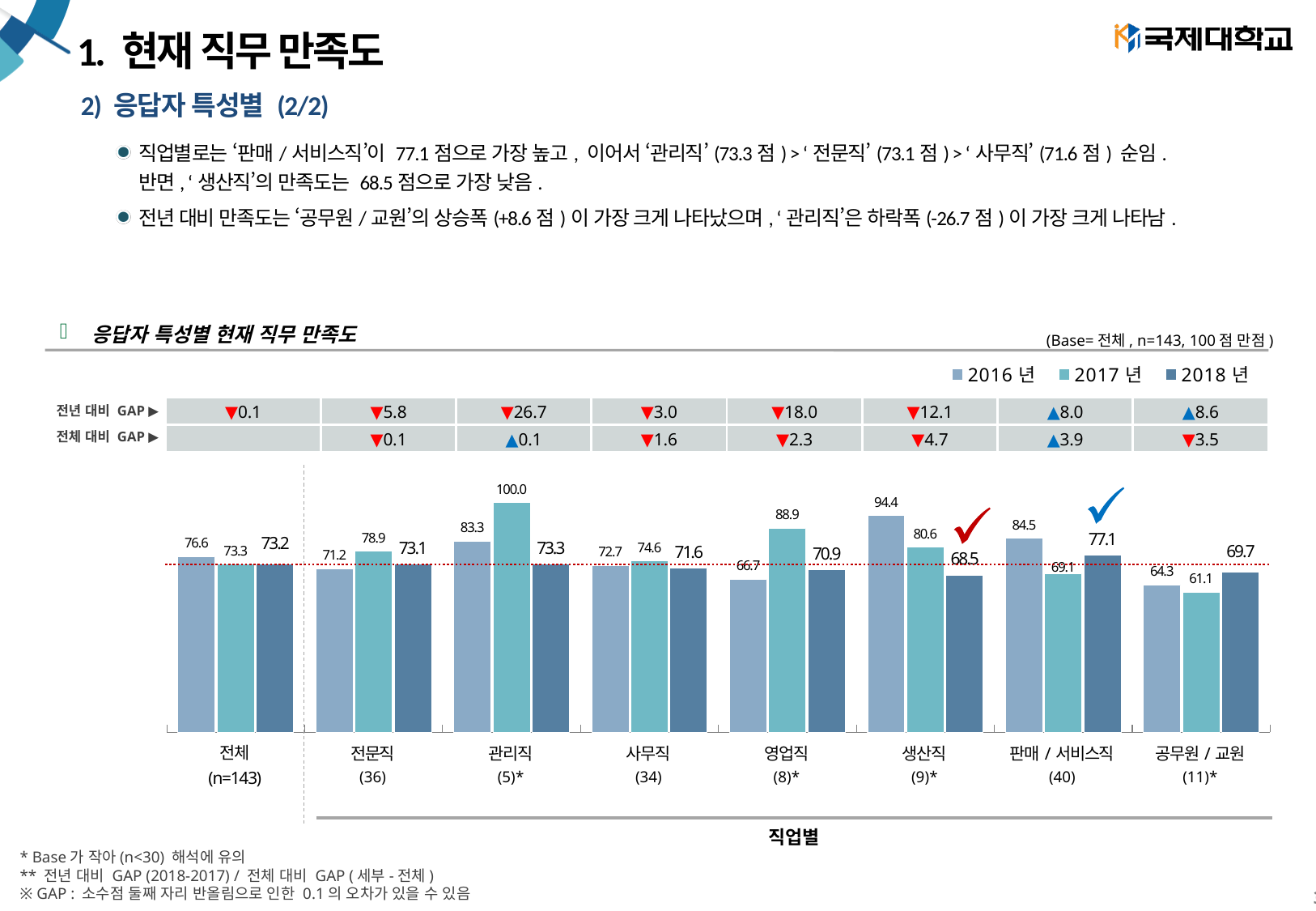
What is the 2017년 value for 관리직? 100.0 How many series does the legend list? 3 What is the 2018년 value for 판매 / 서비스직? 77.1 Which category has the highest 2017년 value? 관리직 What is the 전년 대비 GAP shown for 공무원 / 교원? ▲8.6 What is the difference between the 2017년 and 2018년 values for 관리직? 26.7 What is the 2018년 value for 공무원 / 교원? 69.7 What is the 2016년 value for 생산직? 94.4 What kind of chart is shown on the slide? bar chart Which is larger for 영업직: the 2016년 value or the 2017년 value? 2017년 How many categories are shown on the x axis? 8 Which category has the lowest 2018년 value? 생산직